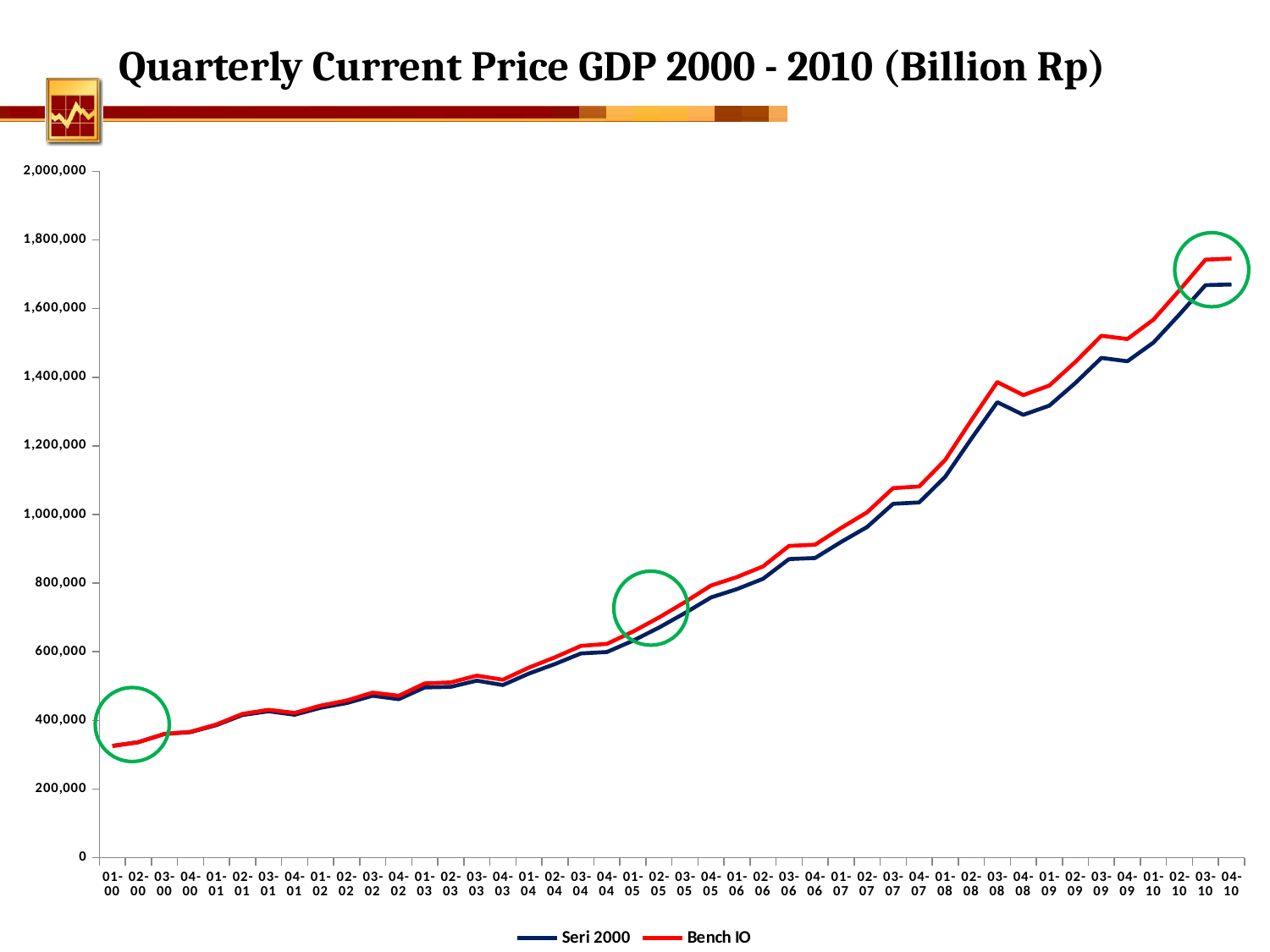
Is the value for Seri 2000 at 01-00 greater or less than 400,000? less How many series does the legend list? 2 Do the GDP values generally rise or fall from 01-00 to 04-10? rise Is the value for Seri 2000 at 04-10 greater or less than 1,600,000? greater Is the value for Bench IO at 04-10 greater or less than 1,800,000? less How many quarterly points are plotted along the x axis? 44 What kind of chart is shown on the slide? line chart What colour is the Bench IO line? red Which quarter has the lowest value for Seri 2000? 01-00 At 04-10, which series is higher, Seri 2000 or Bench IO? Bench IO What are the names of the two series in the legend? Seri 2000 and Bench IO